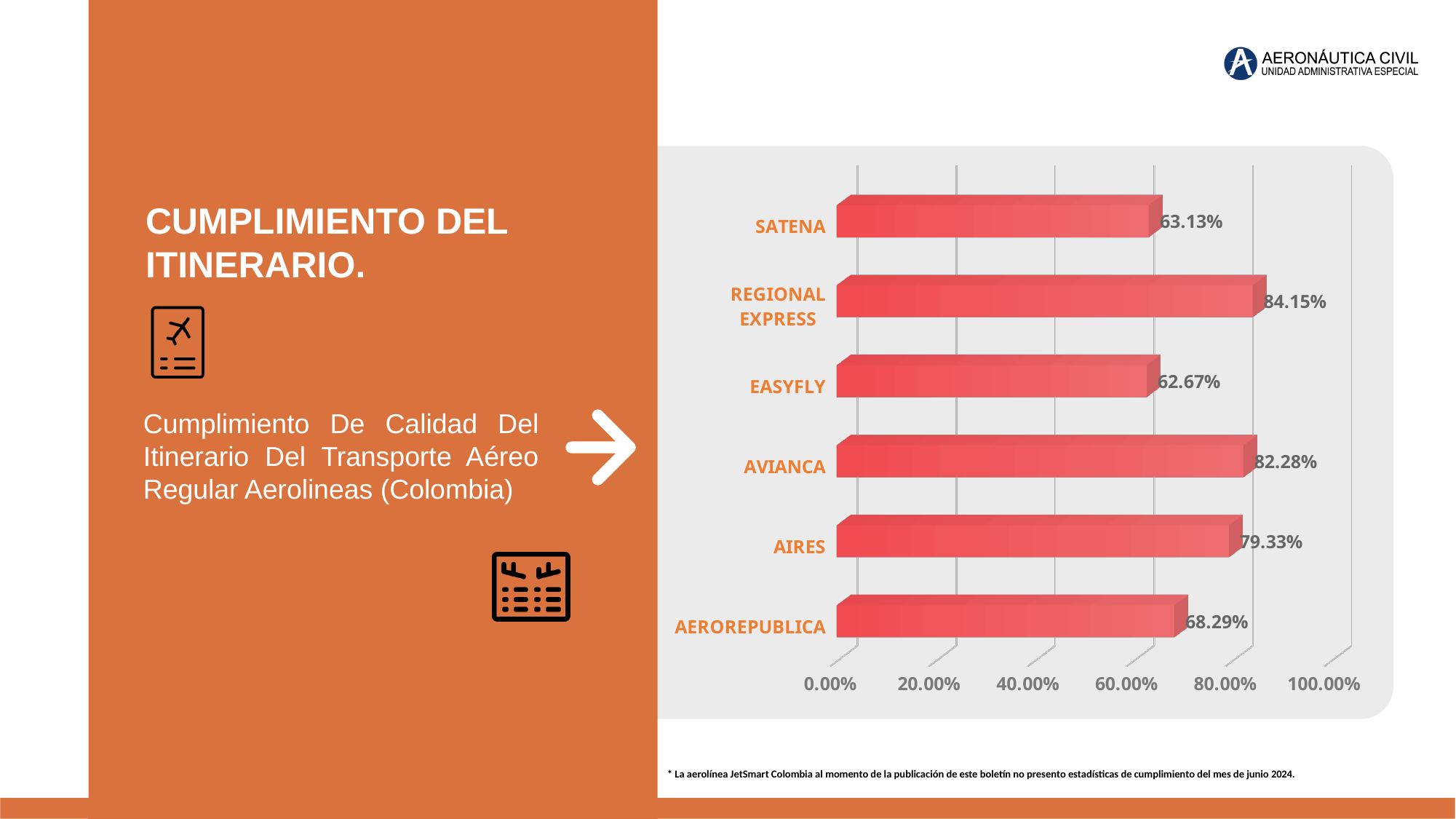
How many airlines are shown in the chart? 6 What is the value for AVIANCA? 82.28% What is the difference between the values for AIRES and AEROREPUBLICA? 11.04% Which airline has the lowest value? EASYFLY Which is larger, the value for AIRES or the value for SATENA? AIRES What is the difference between the values for REGIONAL EXPRESS and AVIANCA? 1.87% Is the value for EASYFLY greater or less than 80.00%? less What is the value for AEROREPUBLICA? 68.29% What kind of chart is shown on the slide? bar chart What is the value for SATENA? 63.13% Which airline has the highest value? REGIONAL EXPRESS What is the value for REGIONAL EXPRESS? 84.15%